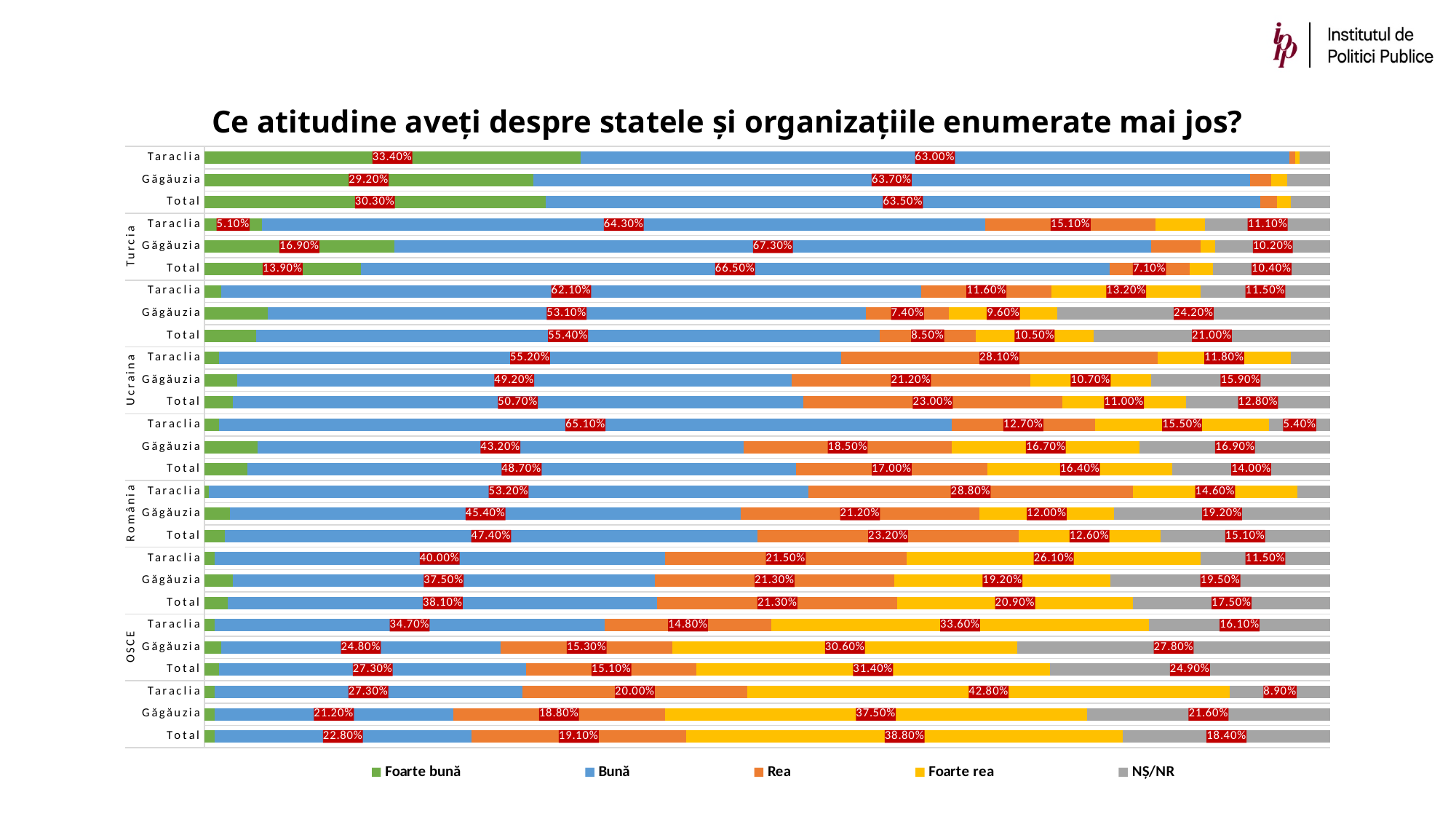
How many bars (rows) are plotted in the chart? 27 What are the legend entries of the chart? Foarte bună, Bună, Rea, Foarte rea, NȘ/NR In the OSCE group, what is the 'Foarte rea' value for Total? 31.40% In the Turcia group, what is the 'Foarte bună' value for Taraclia? 5.10% In the Ucraina group, what is the 'Rea' value for Total? 23.00% In the Turcia group, what is the 'Bună' value for Total? 66.50% In the România group, what is the 'NȘ/NR' value for Găgăuzia? 19.20% In the Turcia group, what is the difference between the 'Bună' values for Găgăuzia (67.30%) and Taraclia (64.30%)? 3.00% How many series does the legend list? 5 What kind of chart is shown on the slide? Stacked bar chart In the Ucraina group, which has the larger 'Rea' value, Taraclia or Găgăuzia? Taraclia What is the title of the chart? Ce atitudine aveți despre statele și organizațiile enumerate mai jos?